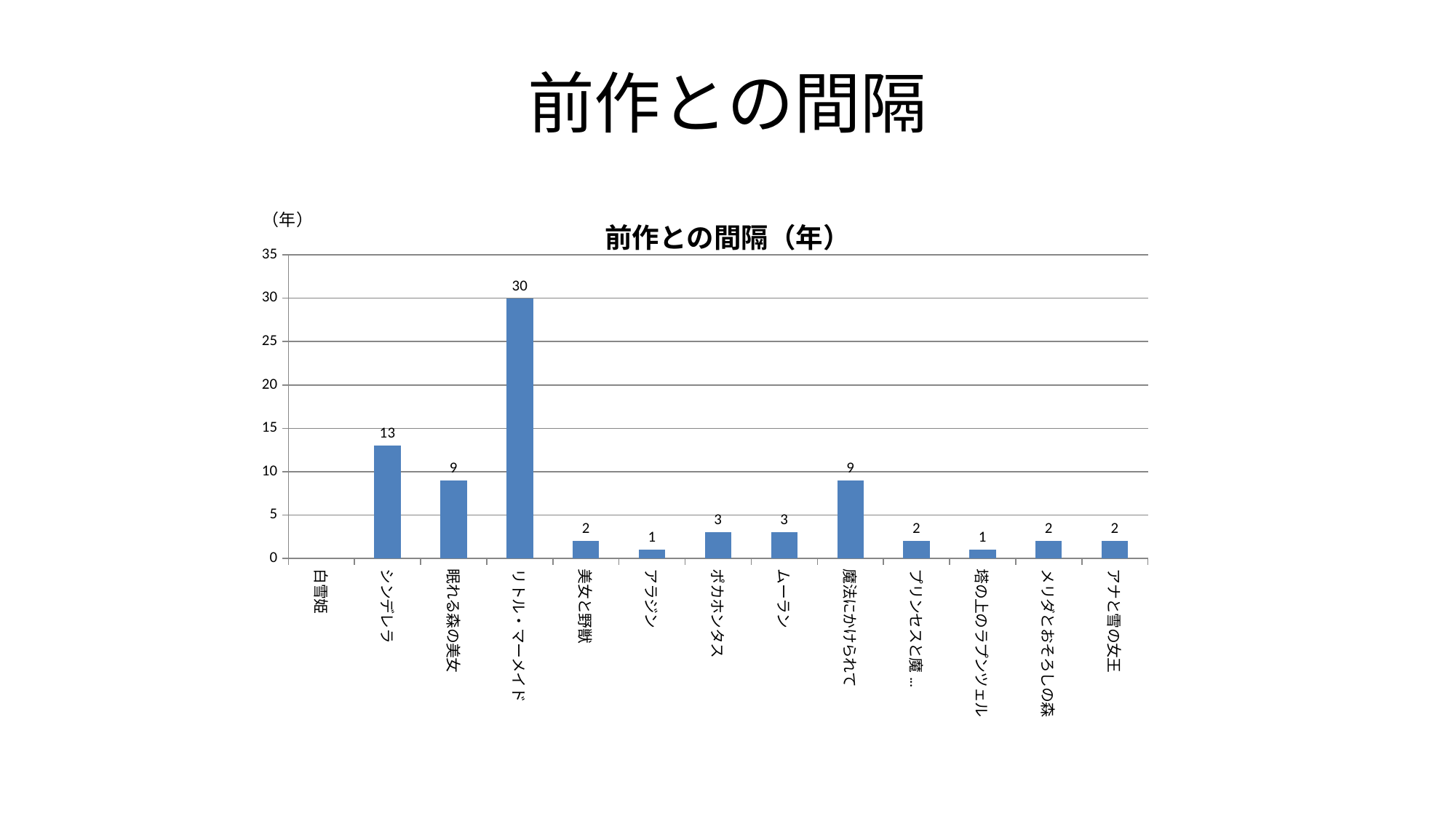
What is the value for アナと雪の女王? 2 How many categories are shown on the x axis? 13 What is the value for アラジン? 1 Which category has the highest value? リトル・マーメイド What is the difference between the values for リトル・マーメイド and シンデレラ? 17 What is the value for シンデレラ? 13 What is the difference between the values for 眠れる森の美女 and 美女と野獣? 7 What is the value for 魔法にかけられて? 9 What is the value for リトル・マーメイド? 30 Which is larger, the value for ポカホンタス or the value for 塔の上のラプンツェル? ポカホンタス What is the title of the chart? 前作との間隔（年） What type of chart is shown on the slide? Bar chart